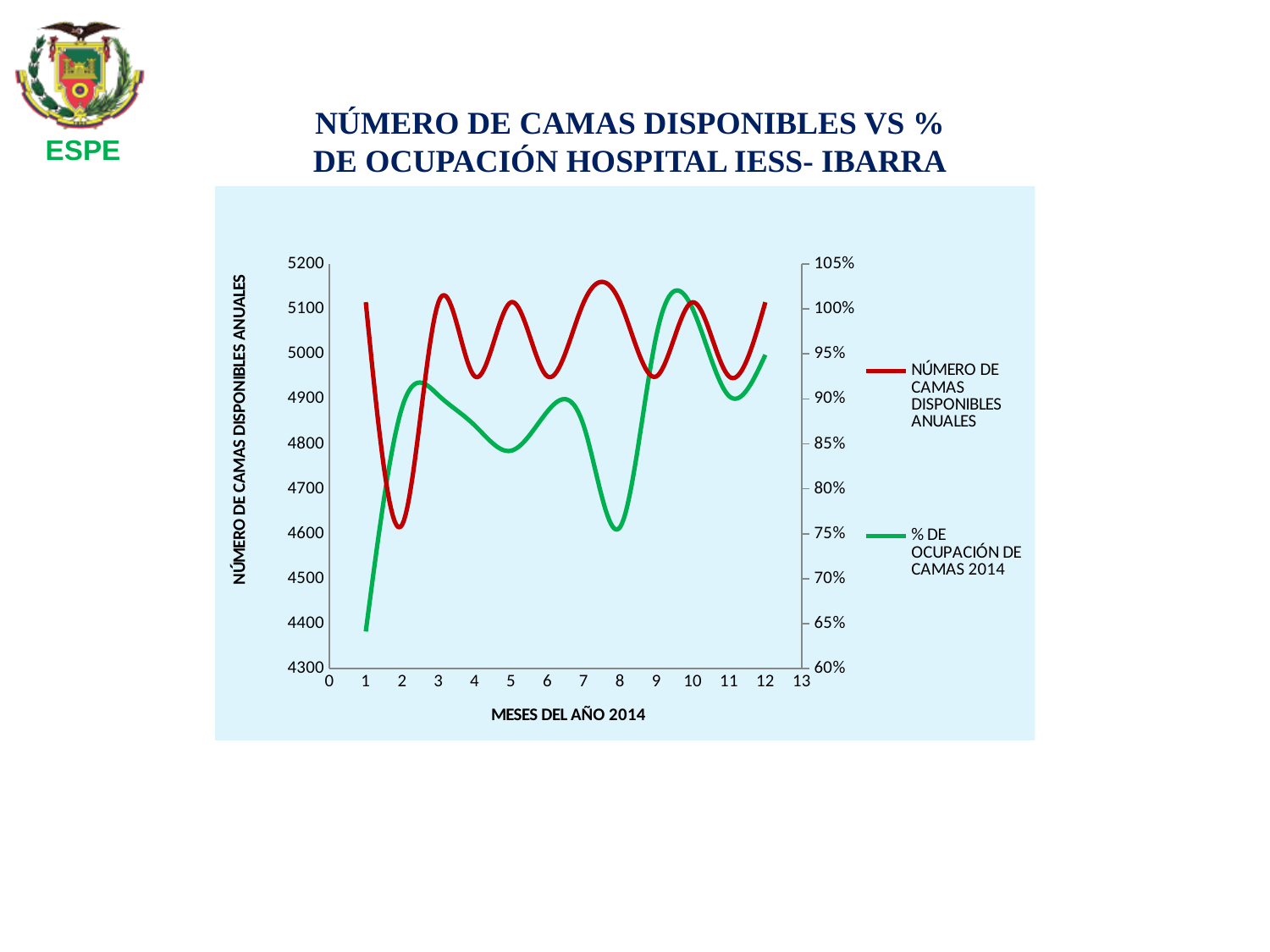
Which series is drawn in green? % DE OCUPACIÓN DE CAMAS 2014 How many months are plotted on the chart? 12 In which month is the NÚMERO DE CAMAS DISPONIBLES ANUALES lowest? 2 Which month has a higher % DE OCUPACIÓN DE CAMAS 2014, month 8 or month 10? 10 How many series does the legend list? 2 In which month is the % DE OCUPACIÓN DE CAMAS 2014 lowest? 1 Is the NÚMERO DE CAMAS DISPONIBLES ANUALES in month 2 greater or less than 4700? less Is the % DE OCUPACIÓN DE CAMAS 2014 in month 1 greater or less than 70%? less What is the title of the x axis? MESES DEL AÑO 2014 What kind of chart is shown on the slide? line chart Is the % DE OCUPACIÓN DE CAMAS 2014 in month 8 greater or less than 80%? less In which month is the % DE OCUPACIÓN DE CAMAS 2014 highest? 10